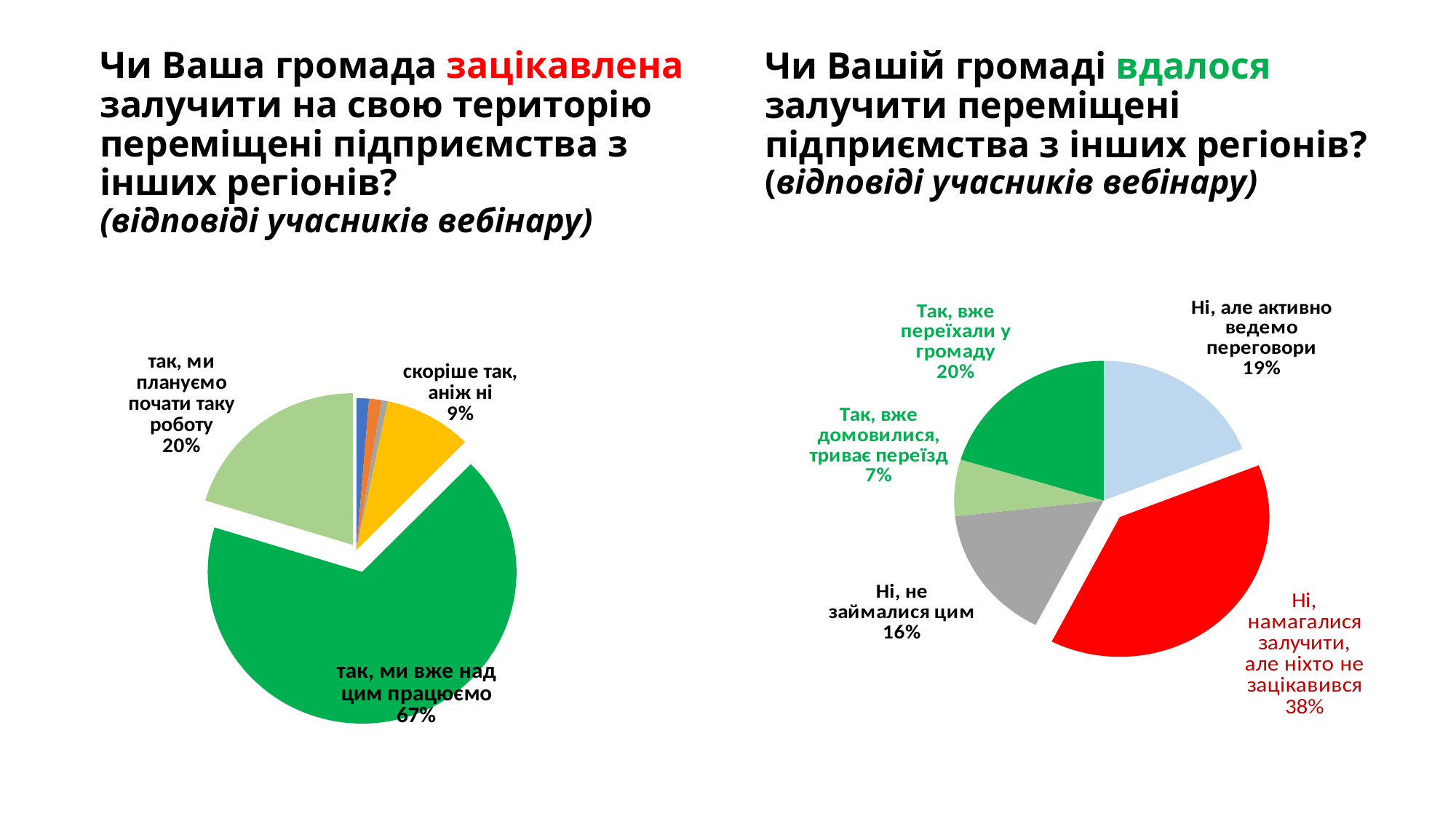
What type of chart is shown on the right side of the slide? Pie chart In the left pie chart, what is the difference between the shares for "так, ми вже над цим працюємо" and "так, ми плануємо почати таку роботу"? 47% In the right pie chart, which is larger: the share for "Так, вже переїхали у громаду" or the share for "Ні, не займалися цим"? Так, вже переїхали у громаду In the left pie chart, which labelled answer has the largest share? так, ми вже над цим працюємо How many slices does the right pie chart have? 5 In the right pie chart, which answer has the smallest share? Так, вже домовилися, триває переїзд In the right pie chart, what share of respondents answered "Так, вже домовилися, триває переїзд"? 7% In the right pie chart, what share of respondents answered "Ні, не займалися цим"? 16% In the left pie chart, what share of respondents answered "скоріше так, аніж ні"? 9% In the left pie chart, what share of respondents answered "так, ми вже над цим працюємо"? 67% In the right pie chart, what share of respondents answered "Ні, намагалися залучити, але ніхто не зацікавився"? 38% In the left pie chart, what share of respondents answered "так, ми плануємо почати таку роботу"? 20%